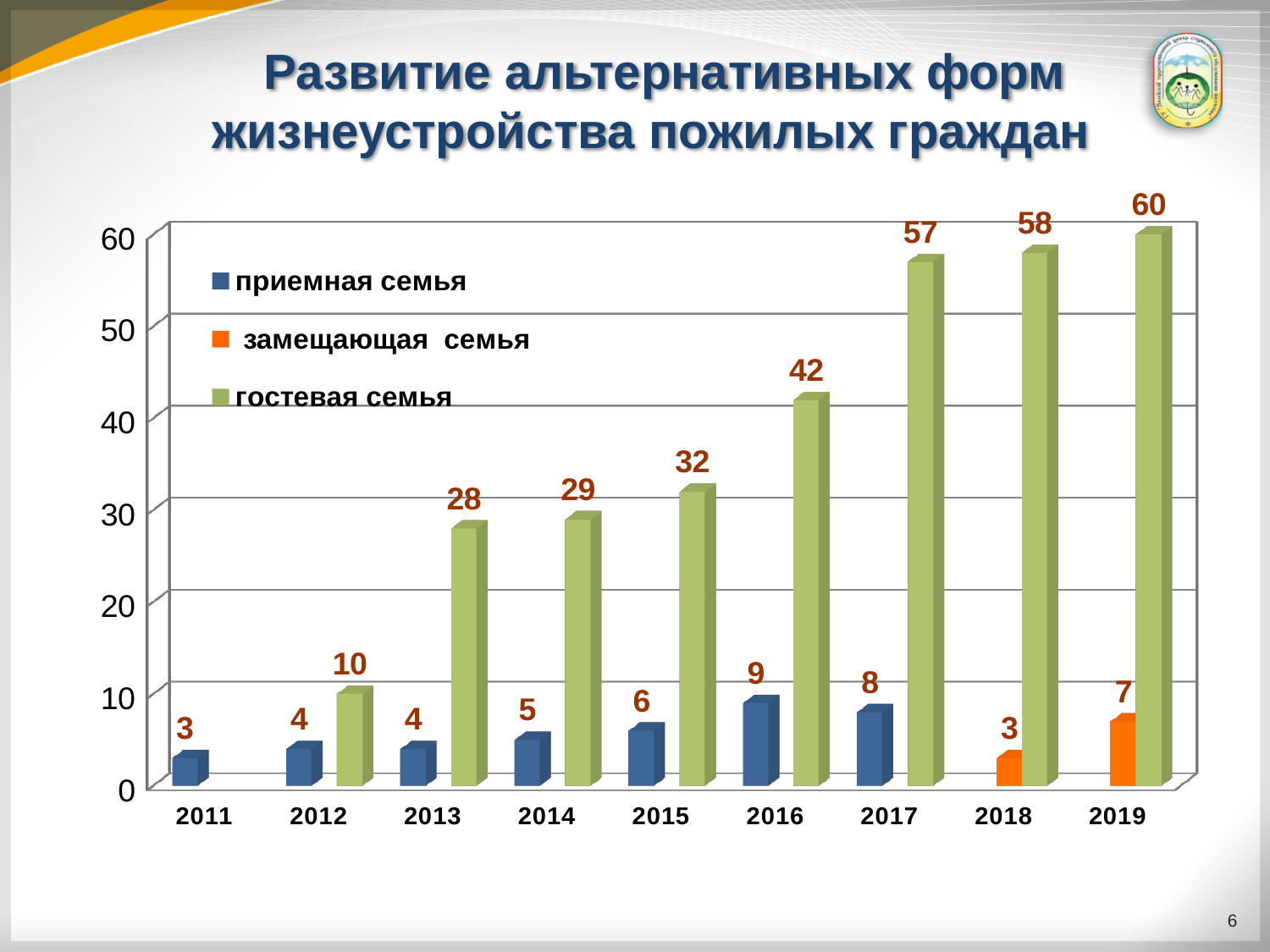
In which year is the value for гостевая семья highest? 2019 Which is larger: приемная семья in 2016 or приемная семья in 2017? приемная семья in 2016 How many years are shown on the x axis? 9 What kind of chart is shown on the slide? bar chart What is the value for приемная семья in 2017? 8 Do the values for гостевая семья rise or fall from 2012 to 2019? rise What is the value for гостевая семья in 2016? 42 In which year is the value for приемная семья lowest? 2011 How many series does the legend list? 3 Is the value for гостевая семья in 2015 greater or less than 30? greater What is the value for замещающая семья in 2019? 7 What is the difference between the гостевая семья values for 2017 and 2016? 15